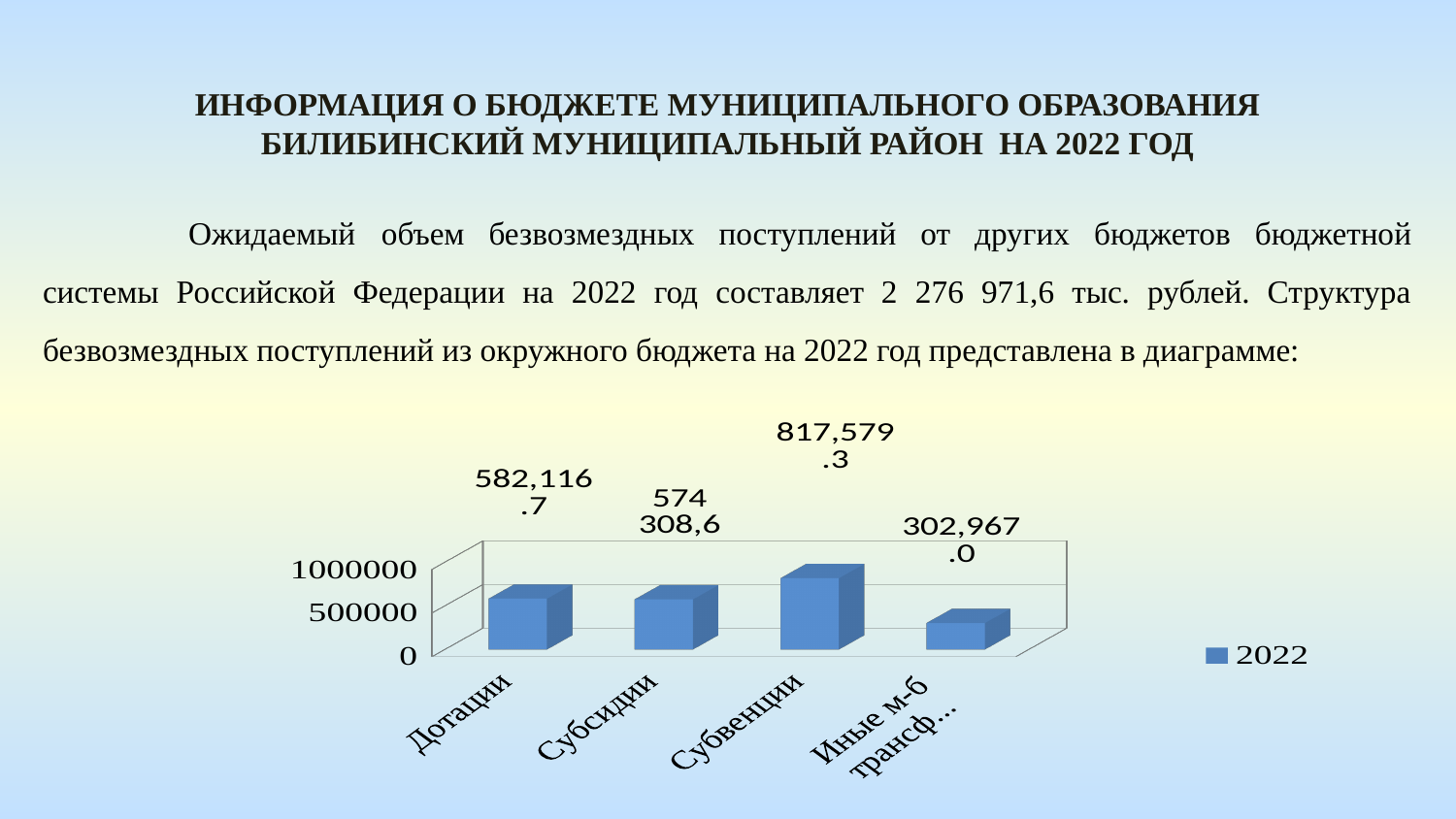
What is the value for Субвенции? 817,579.3 What is the only entry in the chart legend? 2022 What is the value for Субсидии? 574 308,6 How many categories are shown on the x axis? 4 What type of chart is shown on the slide? bar chart What is the value for the category labelled Иные м-б трансф...? 302,967.0 What is the difference between the values for Субвенции and Дотации? 235,462.6 Is the value for Субвенции greater or less than 500000? greater Which category has the highest value? Субвенции Which is larger, the value for Дотации or the value for Субсидии? Дотации Which category has the lowest value? Иные м-б трансф... What is the value for Дотации? 582,116.7